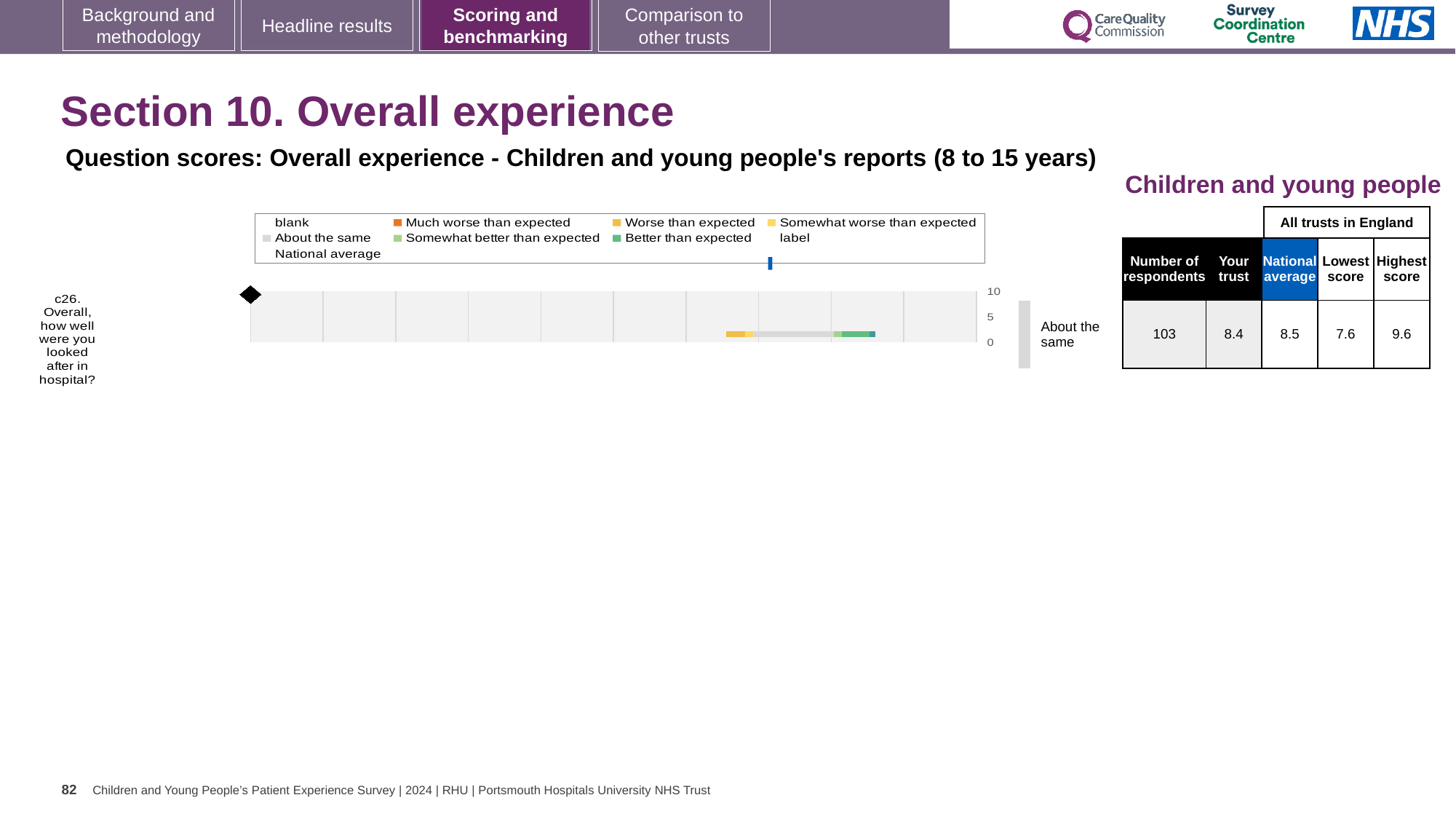
Which is larger for question c26: the trust's score or the national average? National average How many survey questions are plotted on the chart? 1 How is the trust's result for question c26 categorised relative to other trusts? About the same What is the lowest score among all trusts in England for question c26? 7.6 How many respondents answered question c26 'Overall, how well were you looked after in hospital?'? 103 What is the national average score for question c26 'Overall, how well were you looked after in hospital?'? 8.5 What is the difference between the national average and the trust's score for question c26? 0.1 What is the score for 'Your trust' for question c26 'Overall, how well were you looked after in hospital?'? 8.4 What kind of chart is used to show the question score for c26? Bar chart What is the highest score among all trusts in England for question c26? 9.6 What is the difference between the highest score and the lowest score among all trusts in England for question c26? 2.0 What is the maximum value shown on the chart's score axis? 10